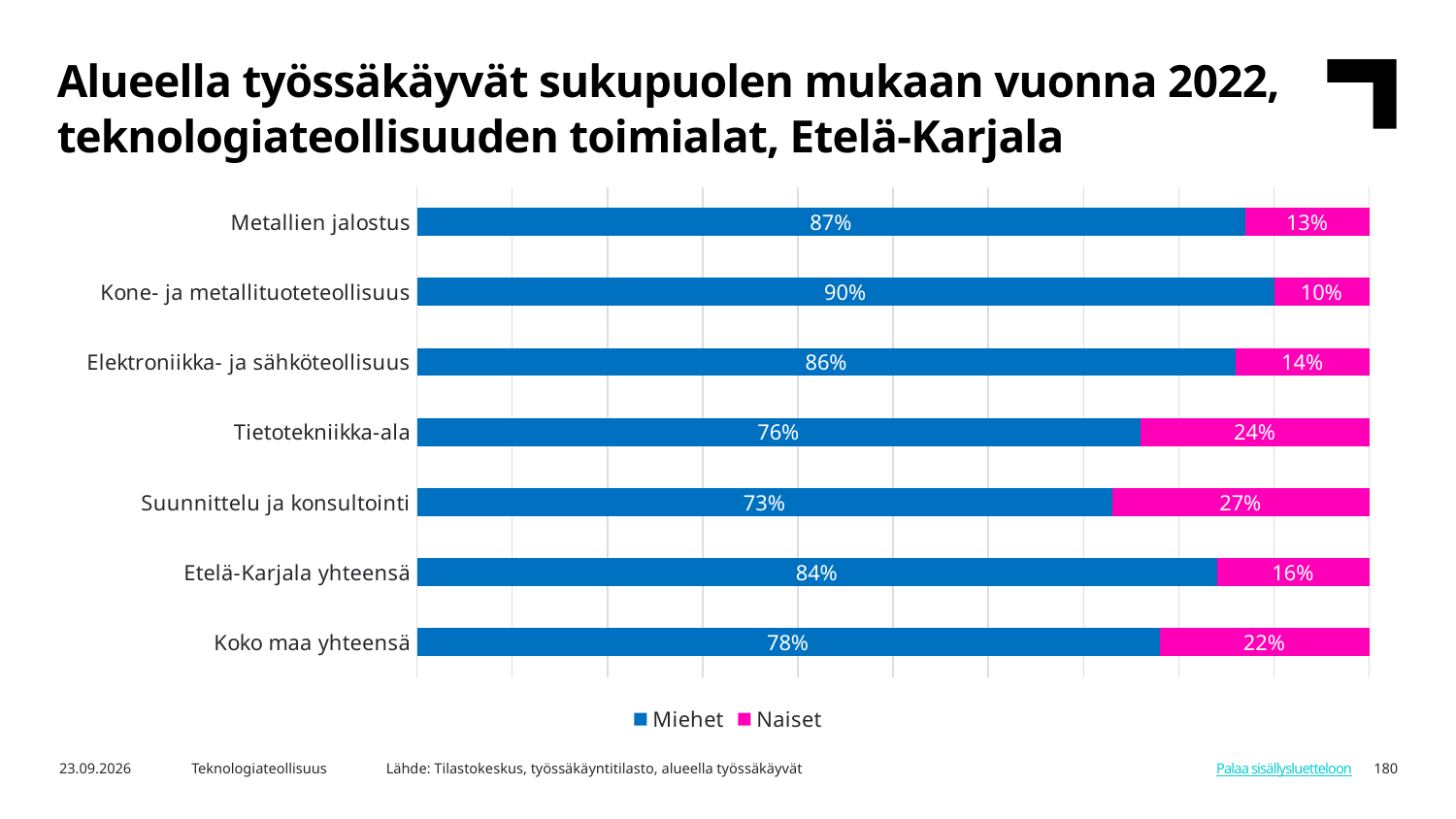
What is the difference between the Miehet share for Etelä-Karjala yhteensä and Koko maa yhteensä? 6 percentage points What is the Naiset share for Suunnittelu ja konsultointi? 27% Which category has the lowest Naiset share? Kone- ja metallituoteteollisuus Which is larger: the Naiset share for Tietotekniikka-ala or for Elektroniikka- ja sähköteollisuus? Tietotekniikka-ala What is the Naiset share for Koko maa yhteensä? 22% What is the Miehet share for Metallien jalostus? 87% What kind of chart is shown on the slide? Stacked bar chart What is the total of the stacked bar for Tietotekniikka-ala? 100% How many series does the legend list? 2 How many categories are shown on the chart? 7 Which category has the highest Miehet share? Kone- ja metallituoteteollisuus Which category has the highest Naiset share? Suunnittelu ja konsultointi